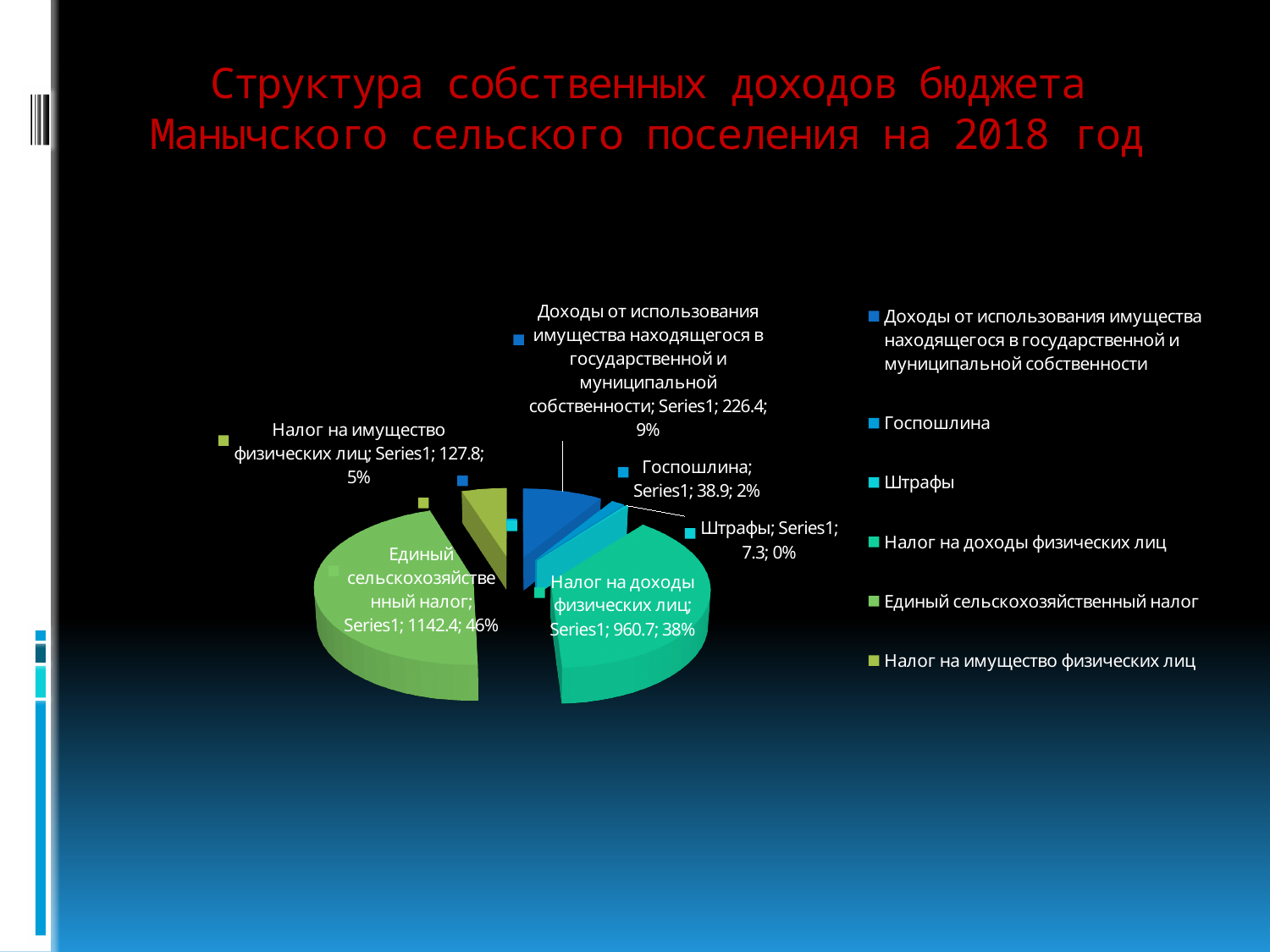
What is the value for Единый сельскохозяйственный налог? 1142.4 Which category has the largest slice of the pie? Единый сельскохозяйственный налог Which is larger, the value for Госпошлина or the value for Налог на имущество физических лиц? Налог на имущество физических лиц What share of the pie does Доходы от использования имущества находящегося в государственной и муниципальной собственности represent? 9% What kind of chart is shown on the slide? pie chart How many categories does the legend list? 6 Which category has the smallest slice of the pie? Штрафы What share of the pie does Налог на имущество физических лиц represent? 5% What is the value for Налог на доходы физических лиц? 960.7 What is the value for Штрафы? 7.3 What is the value for Госпошлина? 38.9 What is the difference between the values for Единый сельскохозяйственный налог and Налог на доходы физических лиц? 181.7